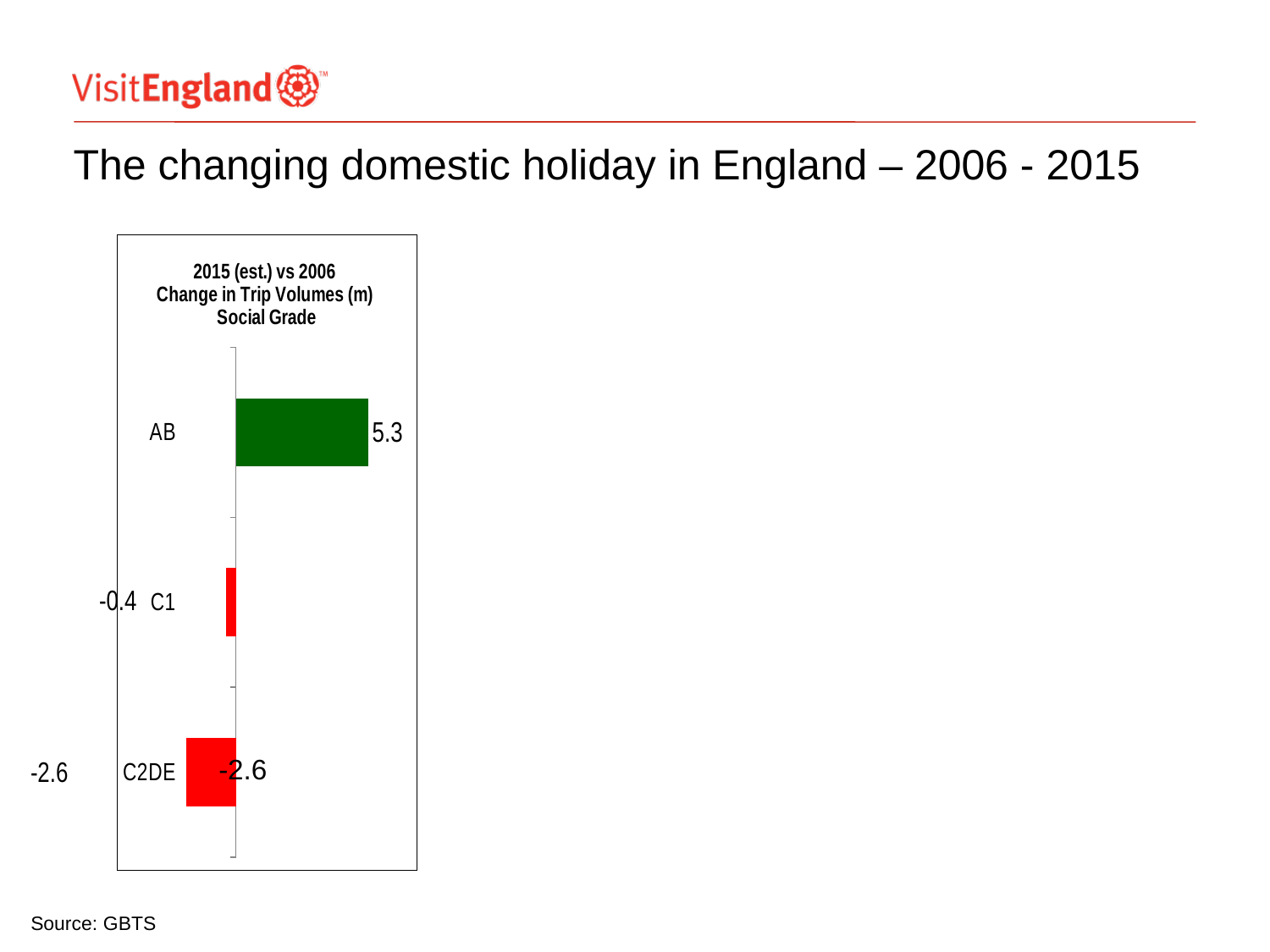
What colour is the bar for the AB social grade? Green What is the title of the chart? 2015 (est.) vs 2006 Change in Trip Volumes (m) Social Grade What is the change in trip volumes for the C1 social grade? -0.4 What is the difference between the change in trip volumes for AB and C2DE? 7.9 What is the change in trip volumes for the C2DE social grade? -2.6 Which has a larger change in trip volumes, C1 or C2DE? C1 What is the difference between the change in trip volumes for C1 and C2DE? 2.2 Which social grade has the lowest change in trip volumes? C2DE What is the change in trip volumes for the AB social grade? 5.3 What kind of chart is shown on the slide? Bar chart Which social grade has the highest change in trip volumes? AB How many social grade categories are shown in the chart? 3